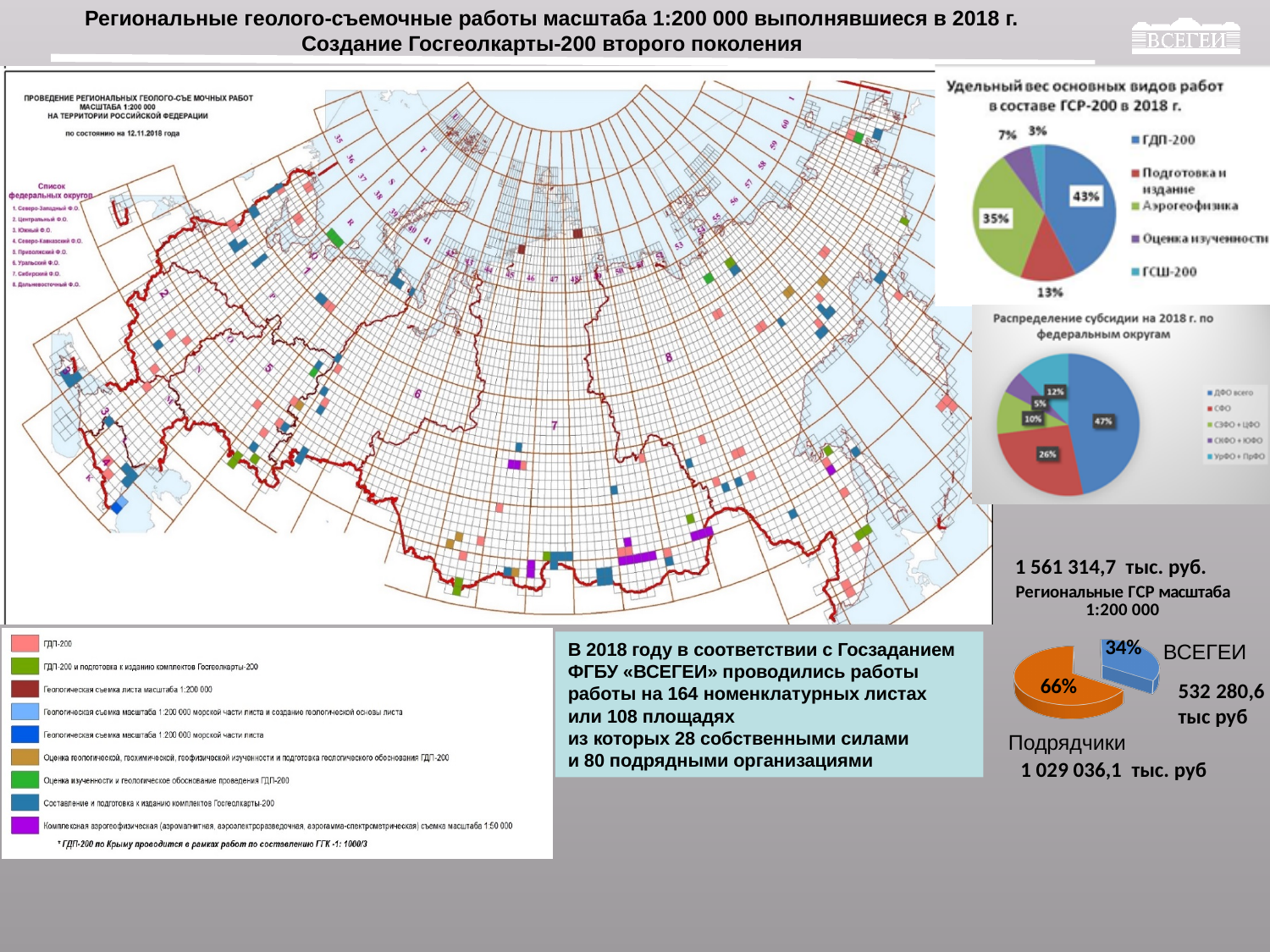
In the pie chart at the bottom right of the slide, which is larger: the share for ВСЕГЕИ or the share for Подрядчики? Подрядчики In the chart titled "Удельный вес основных видов работ в составе ГСР-200 в 2018 г.", how many entries does the legend list? 5 In the chart titled "Удельный вес основных видов работ в составе ГСР-200 в 2018 г.", which type of work has the smallest share? ГСШ-200 What kind of chart is "Распределение субсидии на 2018 г. по федеральным округам"? pie chart In the chart titled "Удельный вес основных видов работ в составе ГСР-200 в 2018 г.", what is the difference in percentage points between ГДП-200 and Подготовка и издание? 30 In the chart titled "Удельный вес основных видов работ в составе ГСР-200 в 2018 г.", what share does Аэрогеофизика have? 35% In the chart titled "Удельный вес основных видов работ в составе ГСР-200 в 2018 г.", what share does ГДП-200 have? 43% In the chart titled "Удельный вес основных видов работ в составе ГСР-200 в 2018 г.", which type of work has the largest share? ГДП-200 In the chart titled "Распределение субсидии на 2018 г. по федеральным округам", what is the smallest share shown? 5% In the chart titled "Распределение субсидии на 2018 г. по федеральным округам", what is the largest share shown? 47% In the pie chart at the bottom right of the slide, what share is attributed to ВСЕГЕИ? 34% In the chart titled "Распределение субсидии на 2018 г. по федеральным округам", how many slices does the pie have? 5